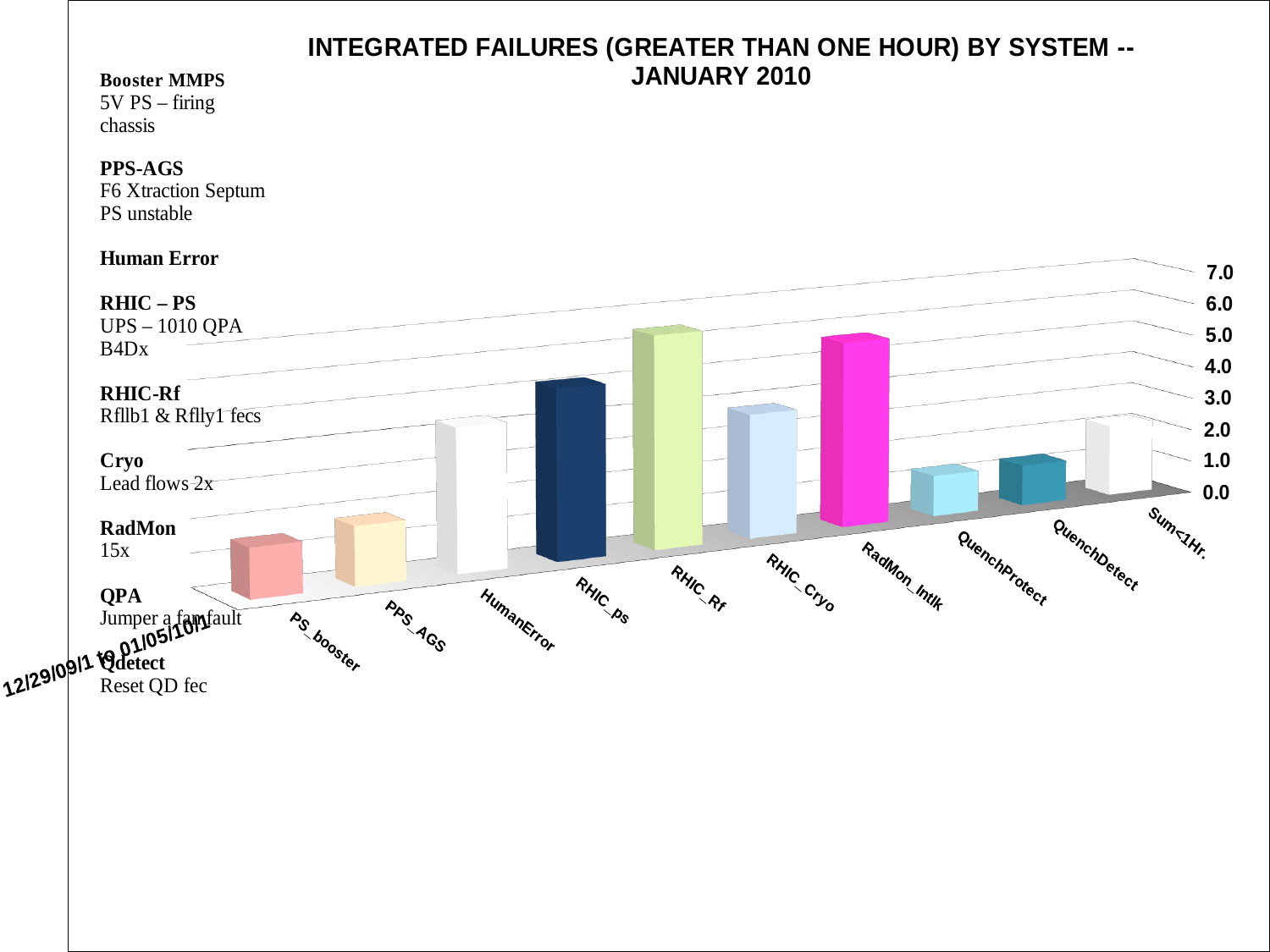
Which has the larger value, RadMon_Intlk or QuenchProtect? RadMon_Intlk What is the highest value shown on the chart's vertical axis? 7.0 Is the value for RHIC_Rf greater or less than 4.0? greater What is the title of the chart? INTEGRATED FAILURES (GREATER THAN ONE HOUR) BY SYSTEM -- JANUARY 2010 Is the value for RadMon_Intlk greater or less than 4.0? greater Is the value for HumanError greater or less than 2.0? greater How many categories are shown on the x axis of the chart? 10 Which has the larger value, RHIC_Rf or RHIC_Cryo? RHIC_Rf What kind of chart is shown on the slide? bar chart